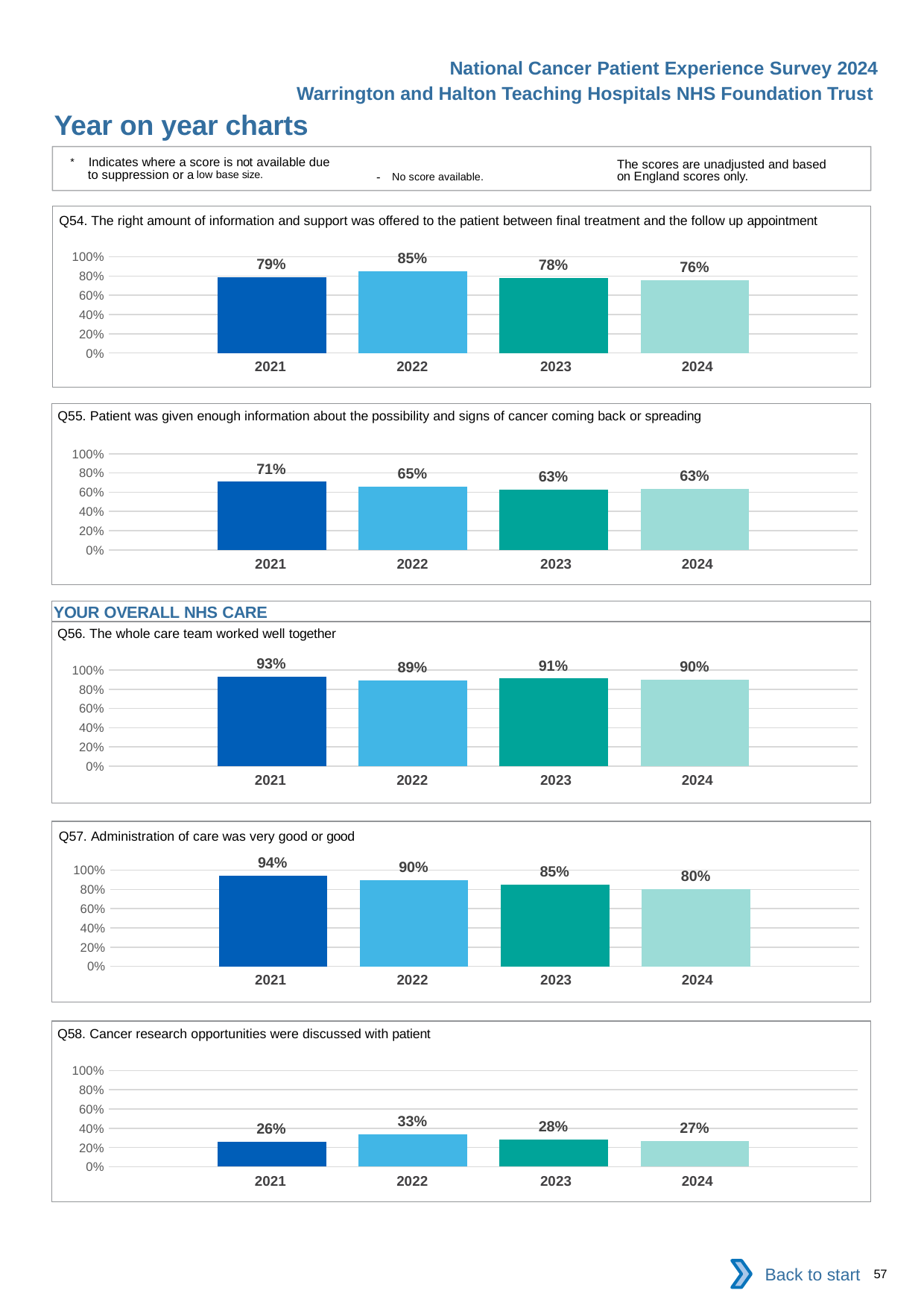
In the Q55 chart, what is the value for 2022? 65% In the Q56 chart, which year has the highest value? 2021 How many years are shown on the x axis of the Q58 chart? 4 In the Q54 chart, what is the value for 2022? 85% What kind of chart is the Q54 chart? bar chart In the Q58 chart, is the value for 2021 greater or less than 40%? less In the Q58 chart, which year has the highest value? 2022 In the Q55 chart, what is the difference between the 2021 and 2024 values? 8% In the Q56 chart, what is the value for 2024? 90% In the Q57 chart, do the values rise or fall from 2021 to 2024? fall In the Q54 chart, which year has the lowest value? 2024 In the Q57 chart, what is the difference between the 2021 and 2024 values? 14%